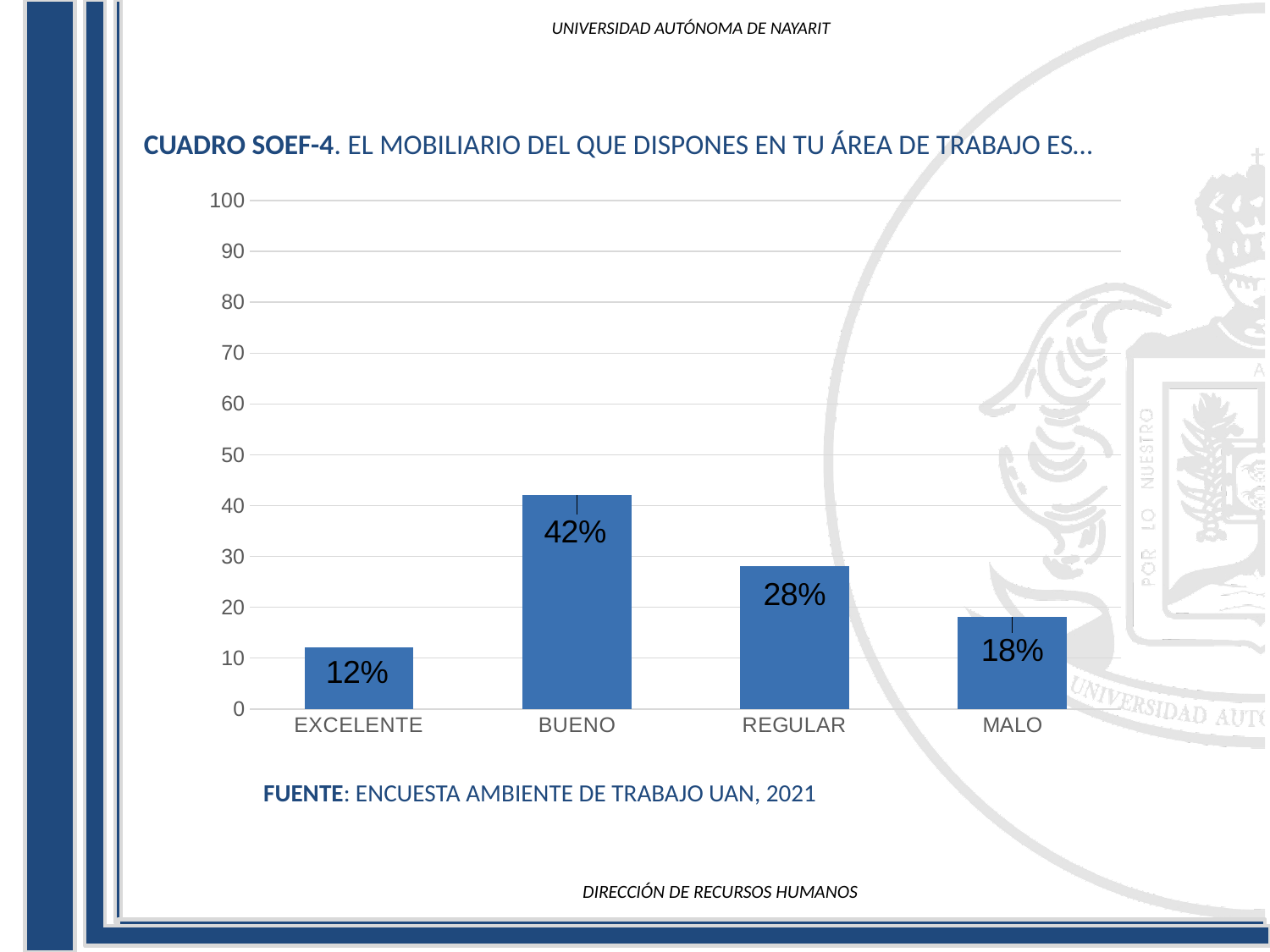
What source is cited below the chart? ENCUESTA AMBIENTE DE TRABAJO UAN, 2021 Which is larger, the value for REGULAR or the value for MALO? REGULAR What is the highest value shown on the y axis? 100 What is the value for BUENO? 42% Is the value for REGULAR greater or less than 20? greater What is the difference between the values for BUENO and REGULAR? 14% What is the value for EXCELENTE? 12% What is the value for MALO? 18% Which category has the highest value? BUENO What kind of chart is shown on the slide? bar chart Which category has the lowest value? EXCELENTE How many categories are shown on the x axis? 4